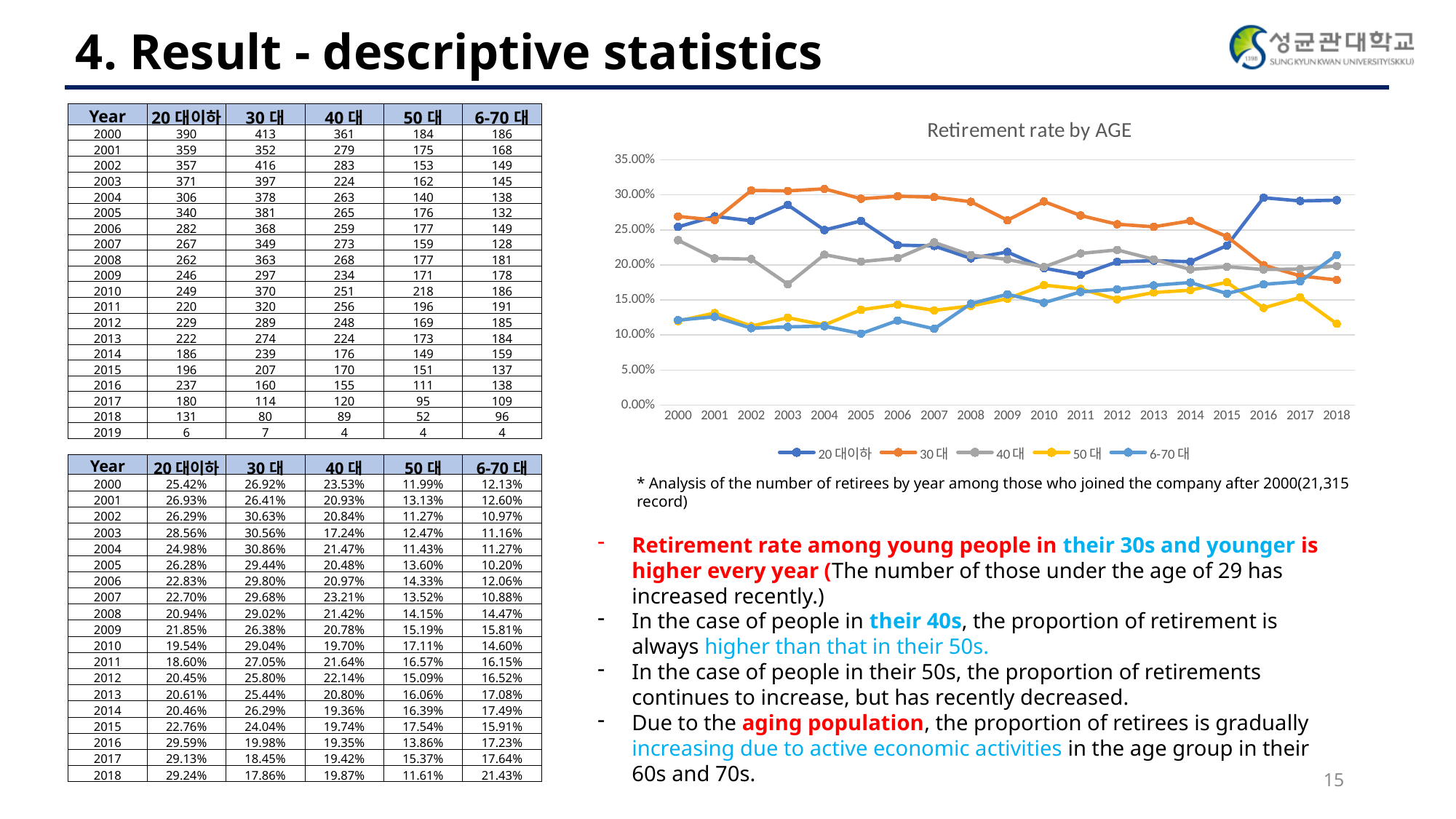
In the 'Retirement rate by AGE' chart, is the value for 50 대 in 2018 greater or less than 15.00%? less In the 'Retirement rate by AGE' chart, which age group has the lowest retirement rate in 2005? 6-70 대 What is the title of the line chart on the slide? Retirement rate by AGE How many years are shown on the x axis of the 'Retirement rate by AGE' chart? 19 How many series does the legend of the 'Retirement rate by AGE' chart list? 5 In the 'Retirement rate by AGE' chart, which is larger in 2016: the value for 20 대이하 or for 30 대? 20 대이하 In the 'Retirement rate by AGE' chart, which age group has the highest retirement rate in 2004? 30 대 In the 'Retirement rate by AGE' chart, does the 30 대 line rise or fall from 2010 to 2018? fall What kind of chart is 'Retirement rate by AGE'? line chart In the 'Retirement rate by AGE' chart, which age group has the highest retirement rate in 2018? 20 대이하 In the 'Retirement rate by AGE' chart, is the value for 30 대 in 2004 greater or less than 25.00%? greater In the 'Retirement rate by AGE' chart, which is larger in 2003: the value for 40 대 or for 50 대? 40 대